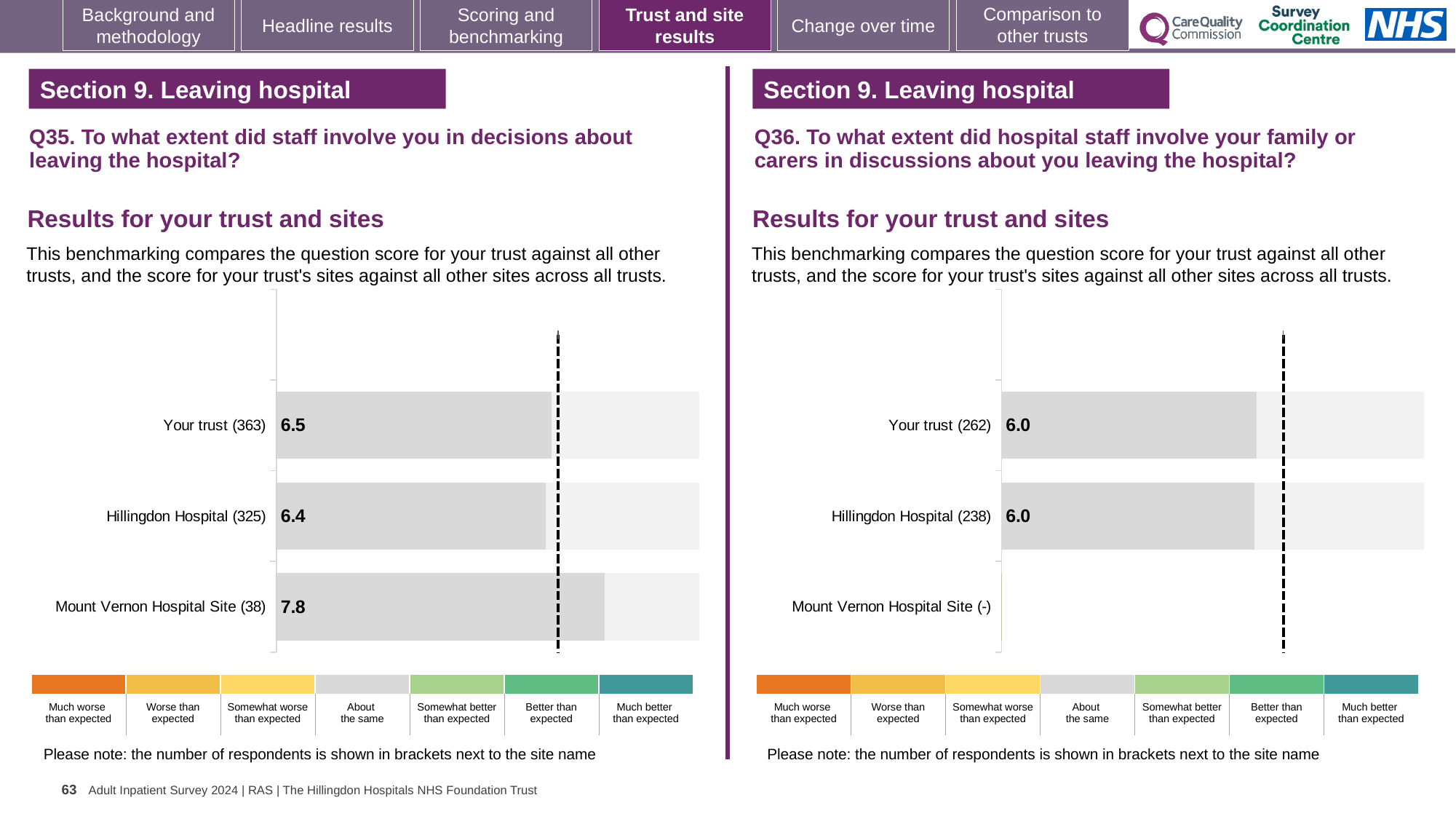
On the Q35 chart (left), what is the score for Your trust? 6.5 On the Q35 chart (left), which has the larger score: Your trust or Hillingdon Hospital? Your trust On the Q35 chart (left), what is the score for Mount Vernon Hospital Site? 7.8 On the Q36 chart (right), how many respondents are shown in brackets for Your trust? 262 On the Q35 chart (left), what is the difference between the Mount Vernon Hospital Site score and the Your trust score? 1.3 On the Q35 chart (left), which site or trust has the lowest score? Hillingdon Hospital How many categories (trust and sites) are listed on the Q35 chart (left)? 3 On the Q35 chart (left), which site or trust has the highest score? Mount Vernon Hospital Site On the Q36 chart (right), what is the score for Your trust? 6.0 What kind of chart is used on the Q36 chart (right)? Bar chart On the Q36 chart (right), what is the score for Hillingdon Hospital? 6.0 On the Q35 chart (left), what is the score for Hillingdon Hospital? 6.4